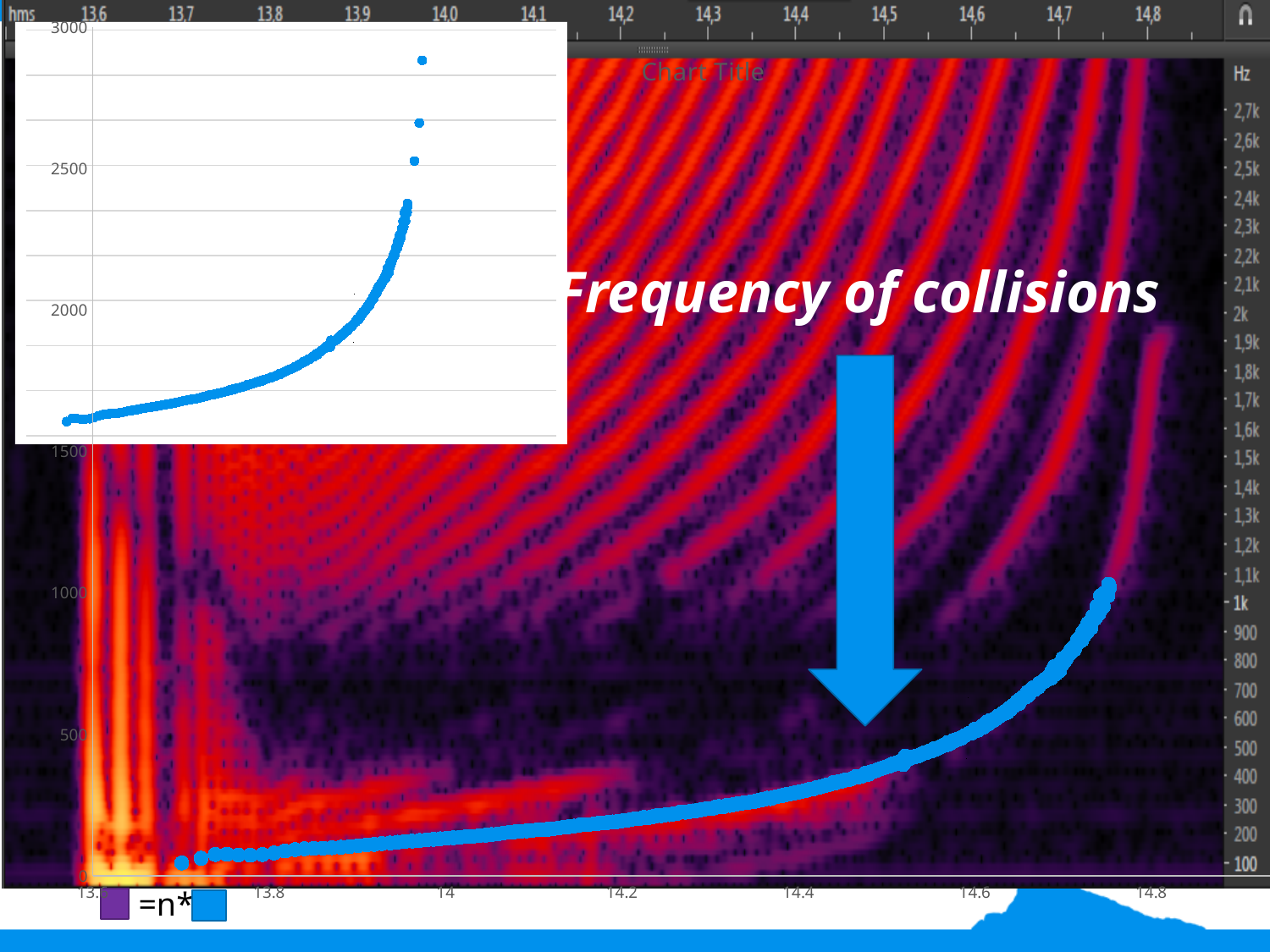
In the large chart overlaid on the spectrogram, do the plotted values rise or fall as the x axis increases from 13.8 to 14.8? rise What kind of chart is the chart in the top-left corner of the slide? scatter chart In the top-left chart, do the plotted values rise or fall from left to right? rise In the large chart overlaid on the spectrogram, is the value of the points near x = 14.2 greater or less than 500? less What kind of chart is the large chart overlaid on the spectrogram in the lower part of the slide? scatter chart In the top-left chart, are the lowest plotted points at the left greater or less than 2000? less What is the highest value labelled on the x axis of the large chart overlaid on the spectrogram? 14.8 In the large chart overlaid on the spectrogram, is the highest plotted point greater or less than 500? greater